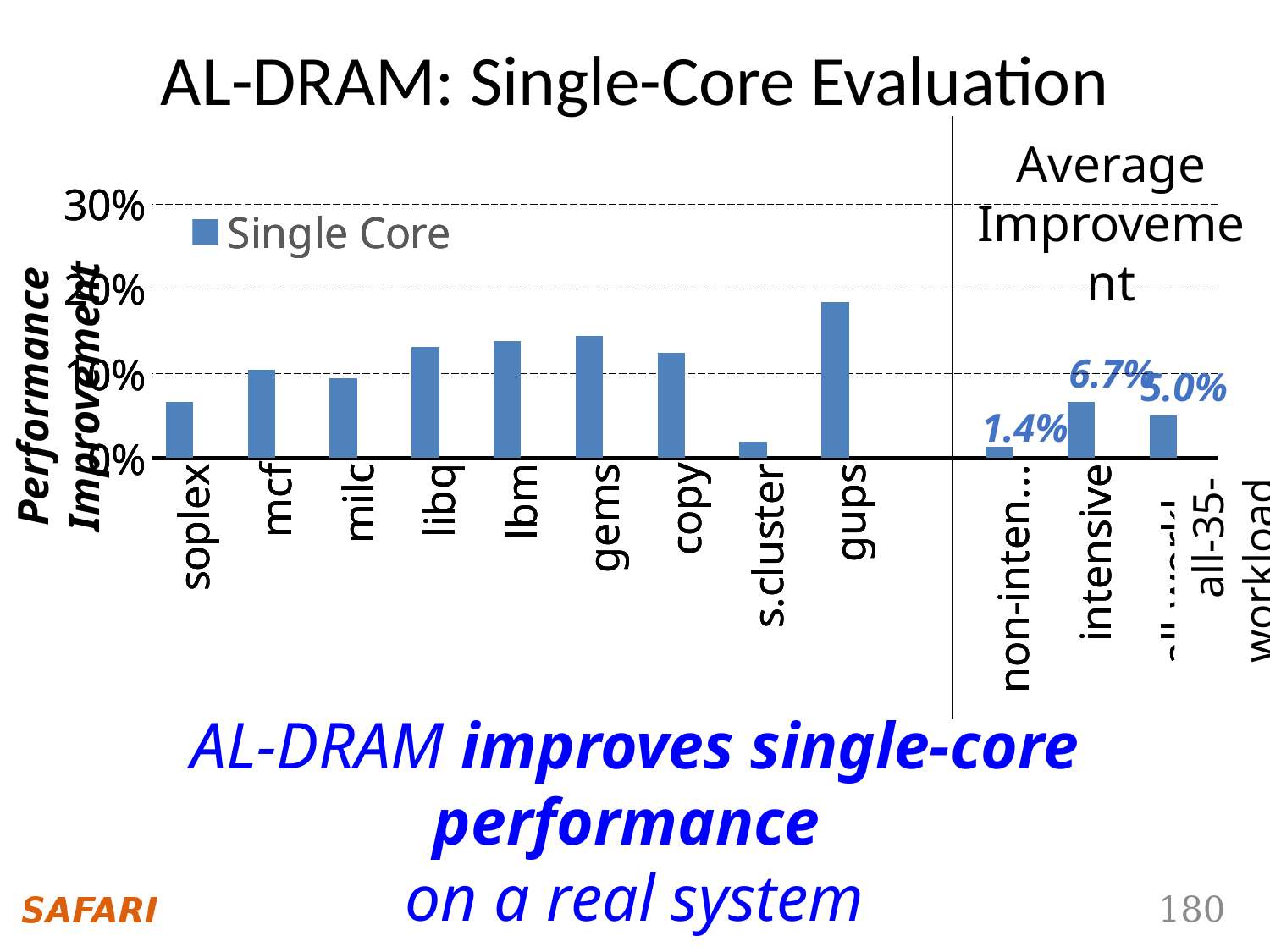
Is the value for gups greater or less than 20%? less How many series does the legend list? 1 What is the value for the all-35-workload category? 5.0% Which is larger, the value for gups or the value for lbm? gups What is the difference between the intensive value and the non-intensive value? 5.3% What kind of chart is shown on the slide? bar chart Among the nine individual benchmarks to the left of the vertical divider, which has the lowest performance improvement? s.cluster Among the nine individual benchmarks to the left of the vertical divider, which has the highest performance improvement? gups Which is larger, the value for intensive or the value for all-35-workload? intensive What is the value for the intensive category? 6.7% What is the value for the non-intensive category? 1.4% Is the value for libq greater or less than 10%? greater